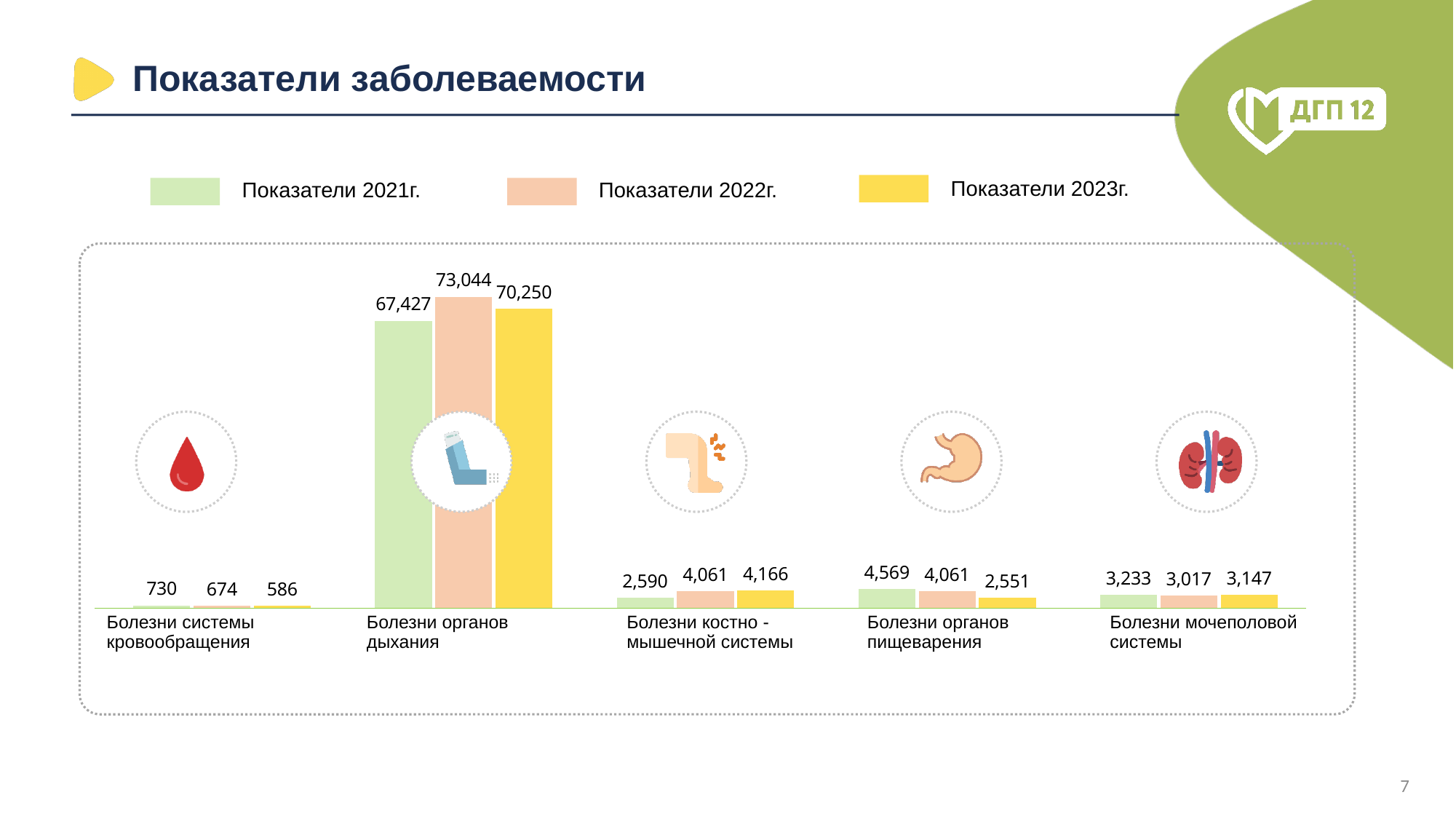
How many series does the legend list? 3 Do the values for Болезни костно-мышечной системы rise or fall from Показатели 2021г. to Показатели 2023г.? Rise Which is larger for Болезни органов пищеварения: the Показатели 2021г. value or the Показатели 2023г. value? Показатели 2021г. What is the value for Болезни мочеполовой системы in the Показатели 2022г. series? 3,017 What is the value for Болезни системы кровообращения in the Показатели 2023г. series? 586 How many categories are shown on the x axis of the chart? 5 What is the value for Болезни органов пищеварения in the Показатели 2021г. series? 4,569 What is the difference between the Показатели 2022г. and Показатели 2021г. values for Болезни органов дыхания? 5,617 What is the value for Болезни органов дыхания in the Показатели 2022г. series? 73,044 Which category has the highest value in the Показатели 2023г. series? Болезни органов дыхания Which category has the lowest value in the Показатели 2021г. series? Болезни системы кровообращения What kind of chart is shown on the slide? Bar chart